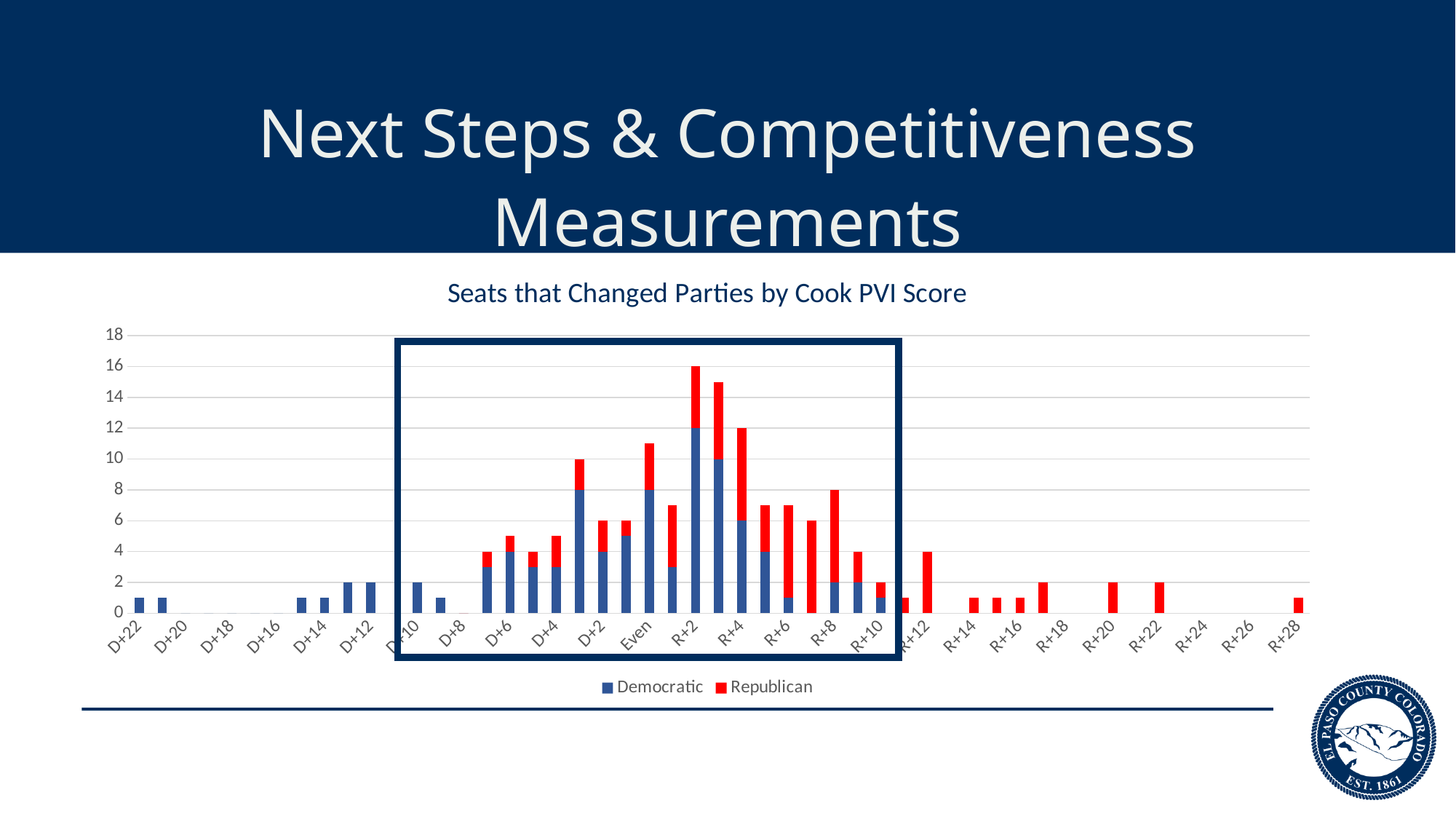
What is the total height of the bar at R+2? 16 What is the total height of the bar at R+8? 8 Is the total value for Even greater or less than 10? greater How many series does the legend list? 2 What kind of chart is shown on the slide? Stacked bar chart What is the total height of the bar at R+4? 12 Which Cook PVI score has the tallest bar? R+2 What is the Democratic value at R+2? 12 Which bar is taller, R+2 or R+4? R+2 Which series is shown in red? Republican Is the total value for R+12 greater or less than 6? less What is the title of the chart? Seats that Changed Parties by Cook PVI Score